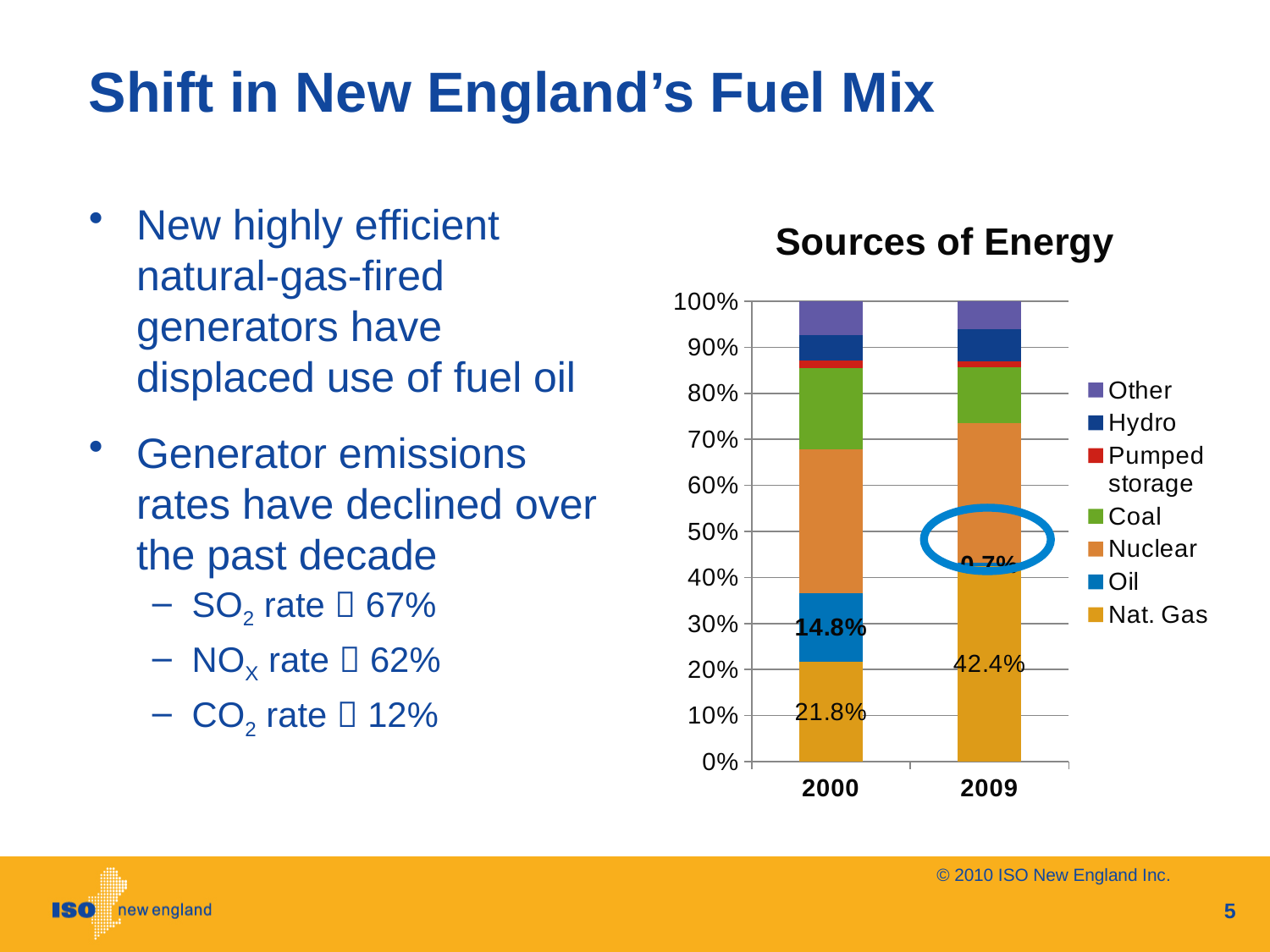
By how many percentage points did the Nat. Gas share increase from 2000 to 2009? 20.6 percentage points What share of energy came from Nat. Gas in 2009 according to the chart? 42.4% Which year has the larger Oil share, 2000 or 2009? 2000 Which series is shown at the bottom of each stacked bar in the Sources of Energy chart? Nat. Gas Does the Nat. Gas share rise or fall from 2000 to 2009? Rise How many years (bars) are shown on the x axis of the Sources of Energy chart? 2 What type of chart is shown under the title "Sources of Energy"? Stacked bar chart Is the Oil share in 2009 greater or less than 10%? less How many series does the legend of the Sources of Energy chart list? 7 What is the title of the chart on the slide? Sources of Energy What share of energy came from Oil in 2000 according to the chart? 14.8% What share of energy came from Nat. Gas in 2000 according to the chart? 21.8%